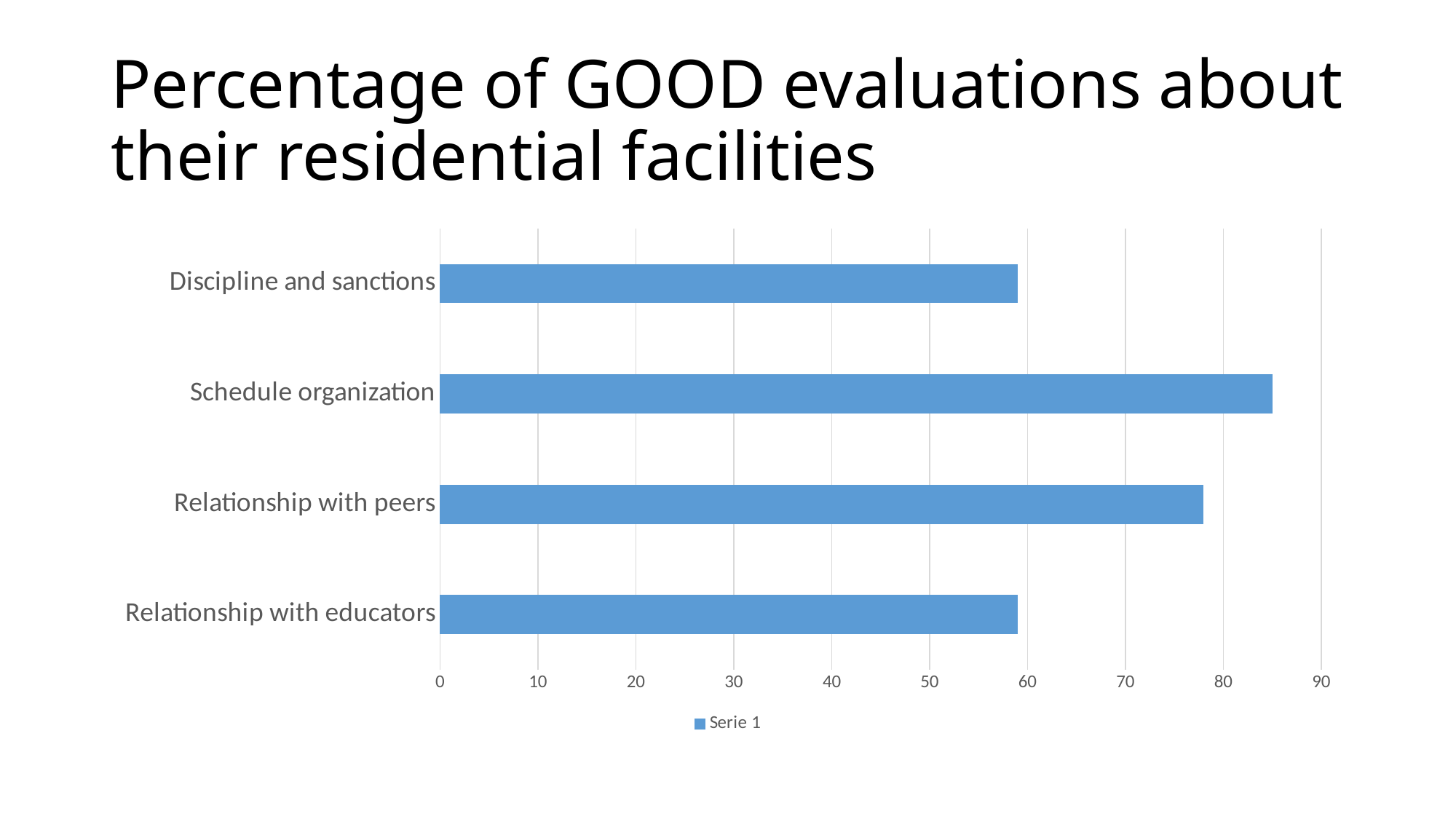
Is the value for Schedule organization greater or less than 80? greater How many categories are shown in the chart? 4 What kind of chart is shown on the slide? bar chart Is the value for Discipline and sanctions greater or less than 50? greater Which is larger, the value for Schedule organization or the value for Relationship with peers? Schedule organization Is the value for Schedule organization greater or less than 90? less What is the name of the series shown in the legend? Serie 1 Which category has the highest value? Schedule organization Which is larger, the value for Relationship with peers or the value for Relationship with educators? Relationship with peers How many series does the legend list? 1